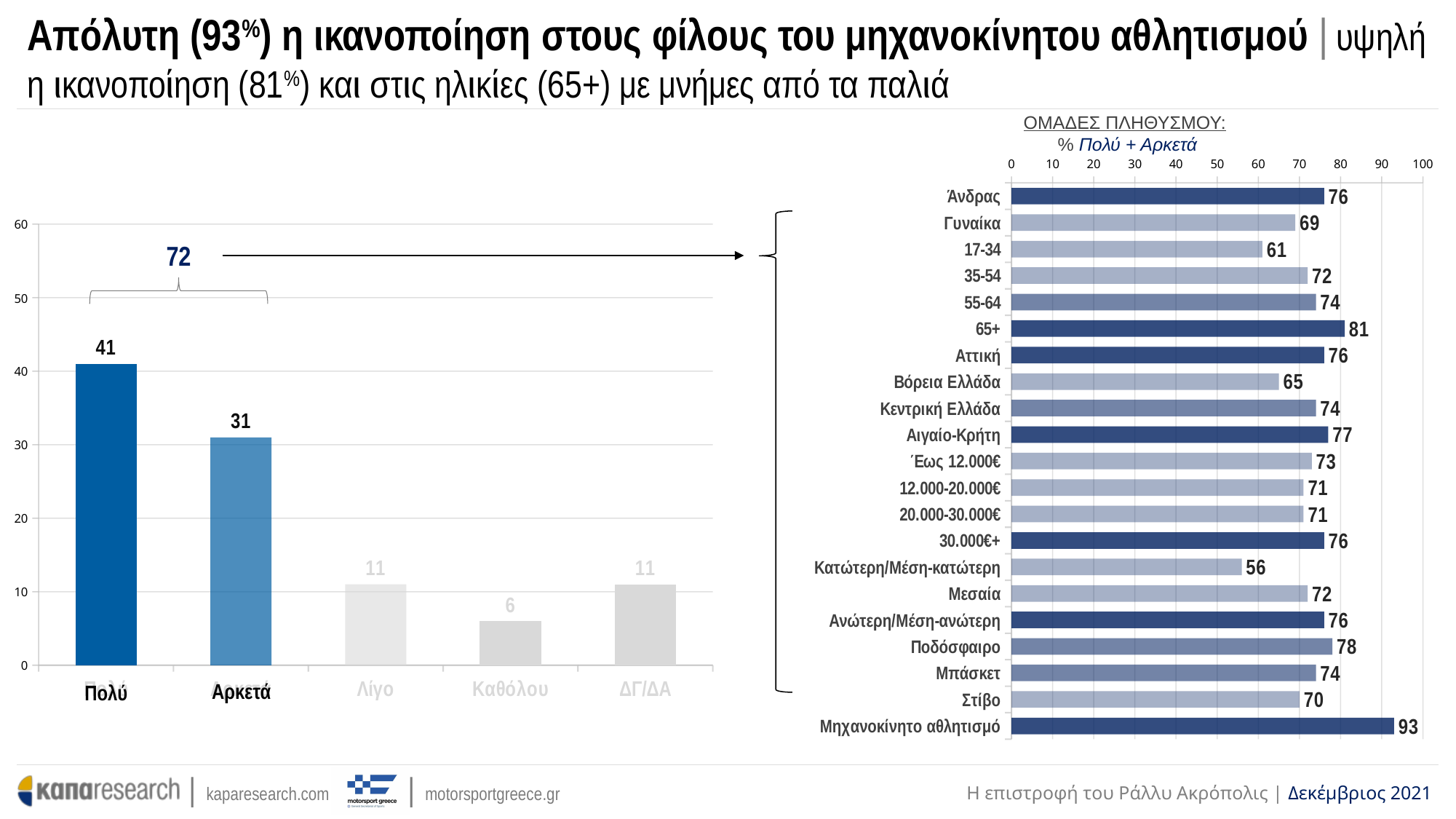
In the right chart (ΟΜΑΔΕΣ ΠΛΗΘΥΣΜΟΥ), which is larger, the value for Άνδρας or the value for Γυναίκα? Άνδρας In the right chart (ΟΜΑΔΕΣ ΠΛΗΘΥΣΜΟΥ), what is the value for 65+? 81 In the right chart (ΟΜΑΔΕΣ ΠΛΗΘΥΣΜΟΥ), what is the value for Κατώτερη/Μέση-κατώτερη? 56 In the right chart (ΟΜΑΔΕΣ ΠΛΗΘΥΣΜΟΥ), what is the difference between the values for Ποδόσφαιρο and Στίβο? 8 In the left bar chart, what is the value for Πολύ? 41 In the left bar chart, what is the difference between the values for Πολύ and Αρκετά? 10 In the left bar chart, what is the value for Καθόλου? 6 In the left bar chart, which category has the highest value? Πολύ In the left bar chart, how many categories are shown on the x axis? 5 What kind of chart is the chart on the right of the slide? Bar chart In the left bar chart, which category has the lowest value? Καθόλου In the right chart (ΟΜΑΔΕΣ ΠΛΗΘΥΣΜΟΥ), which category has the highest value? Μηχανοκίνητο αθλητισμό